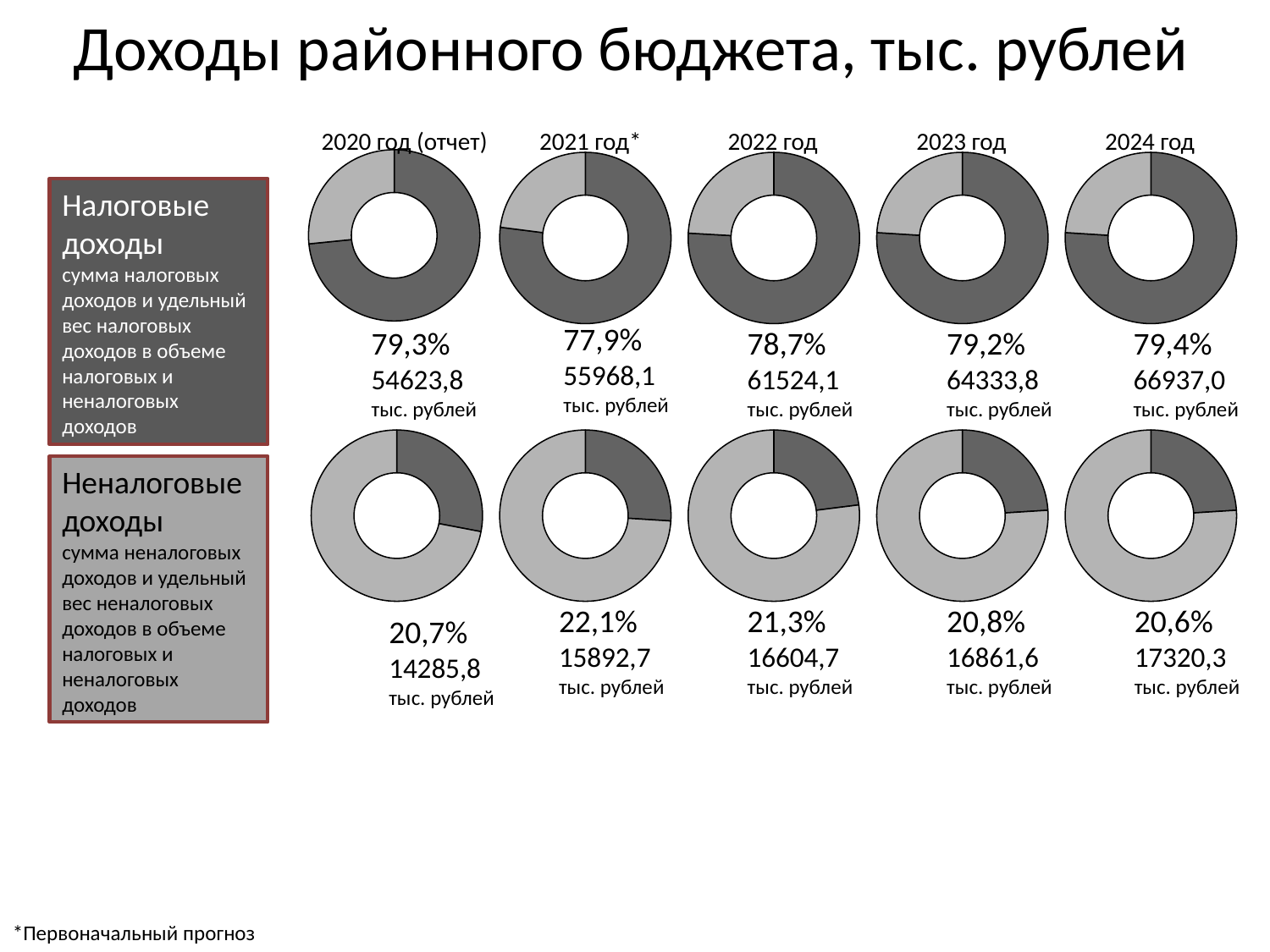
Do the non-tax revenue amounts (Неналоговые доходы) rise or fall from 2020 to 2024? Rise What is the difference between the tax revenue amounts for 2024 год and 2023 год? 2603,2 тыс. рублей What share of the budget do non-tax revenues (Неналоговые доходы) make up in 2021 год*? 22,1% What kind of chart is used to show the revenue shares on this slide? Donut (ring) chart How many donut charts are shown on the slide? 10 In which year is the amount of tax revenues (Налоговые доходы) the highest? 2024 год What is the amount of tax revenues (Налоговые доходы) shown for 2022 год? 61524,1 тыс. рублей In which year is the share of tax revenues (Налоговые доходы) the lowest? 2021 год* In which year is the share of non-tax revenues (Неналоговые доходы) the highest? 2021 год* Which is larger: the non-tax revenue amount for 2022 год or for 2023 год? 2023 год What share of the budget do tax revenues (Налоговые доходы) make up in 2020 год (отчет)? 79,3% What is the amount of non-tax revenues (Неналоговые доходы) shown for 2024 год? 17320,3 тыс. рублей